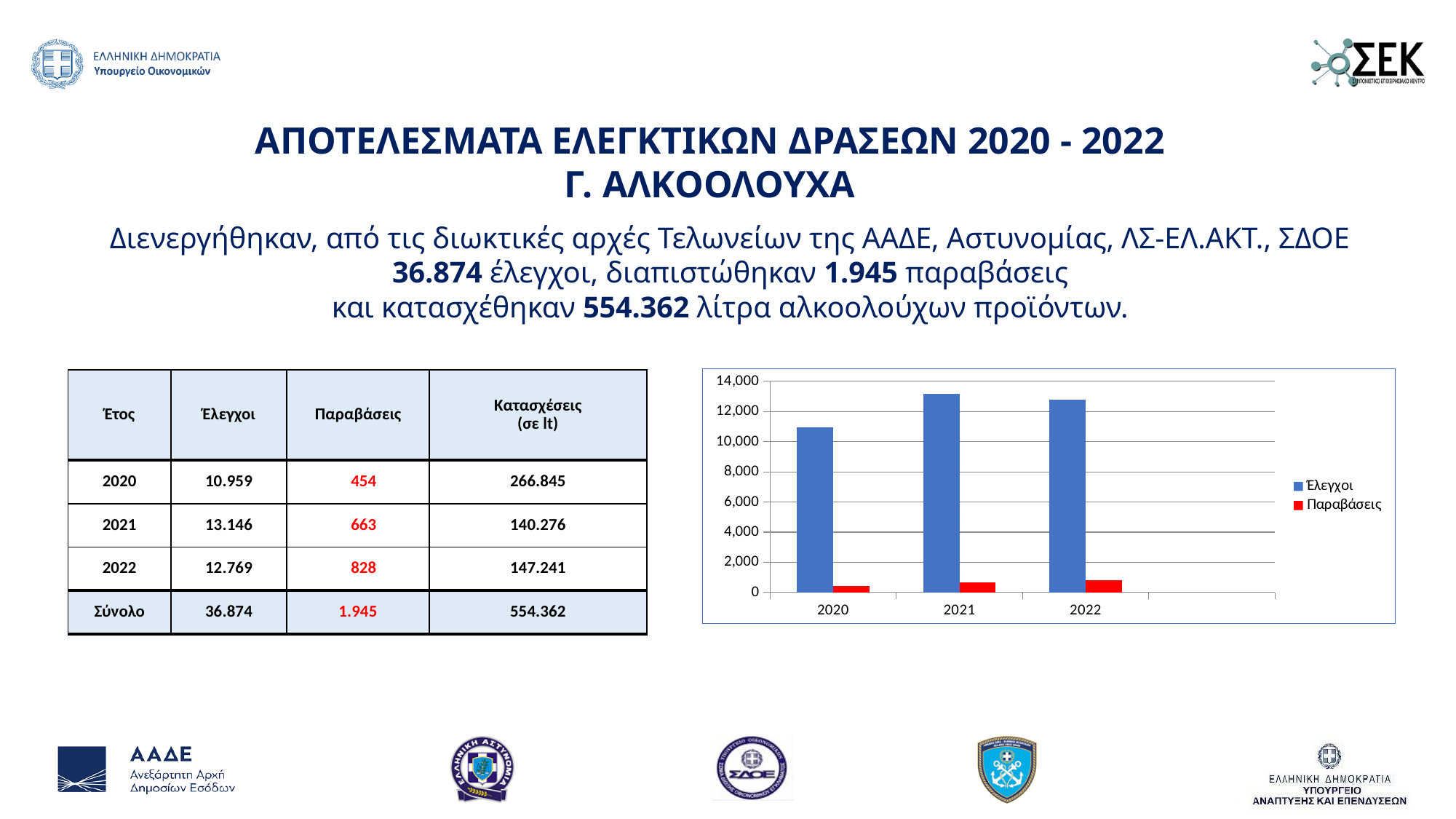
Do the values for Παραβάσεις rise or fall from 2020 to 2022 in the chart? rise Is the value for Έλεγχοι in 2021 greater or less than 12,000? greater How many years are shown on the x axis of the chart? 3 What colour are the bars for Παραβάσεις in the chart? red Is the value for Έλεγχοι in 2020 greater or less than 10,000? greater Which year has the lowest value for Παραβάσεις in the chart? 2020 Which is larger in the chart: Έλεγχοι in 2021 or Έλεγχοι in 2022? 2021 How many series does the chart legend list? 2 Which year has the highest value for Έλεγχοι in the chart? 2021 Is the value for Παραβάσεις in 2022 greater or less than 2,000? less What kind of chart is shown on the slide? bar chart Which year has the lowest value for Έλεγχοι in the chart? 2020